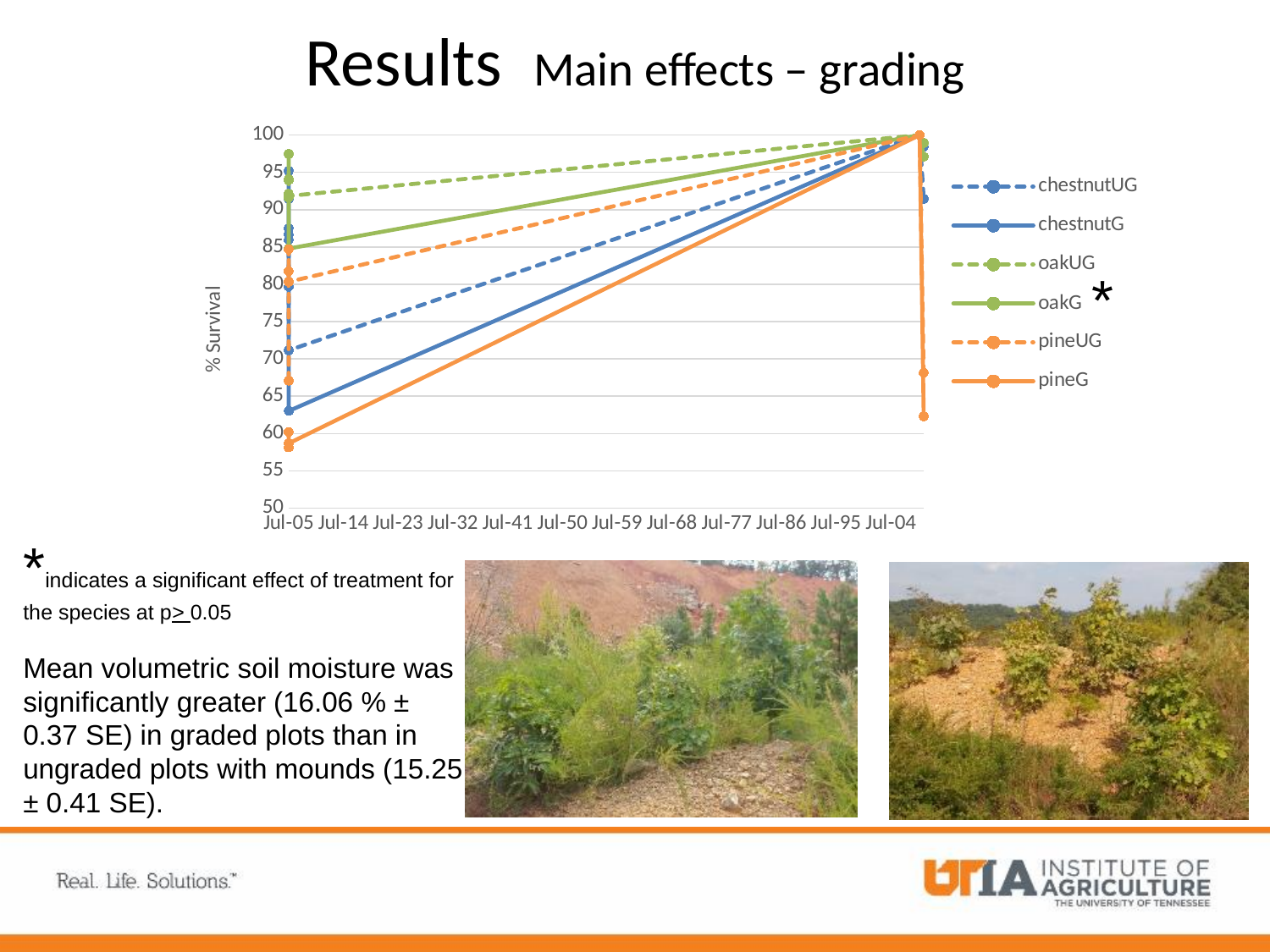
Which series in the legend is marked with an asterisk? oakG At the left end of the chart, is the value for pineUG greater or less than 75? greater At the left end of the chart, is the value for oakG greater or less than 80? greater At the left end of the chart, is the value for chestnutG greater or less than 70? less Which series has the highest % Survival at the left end of the chart? oakUG What is the label of the vertical axis of the chart? % Survival At the left end of the chart, which is higher, oakUG or chestnutUG? oakUG Do the series lines generally rise or fall from the left end of the chart toward the right end? rise Which series has the lowest % Survival at the left end of the chart? pineG What kind of chart is shown on the slide? line chart How many series does the chart legend list? 6